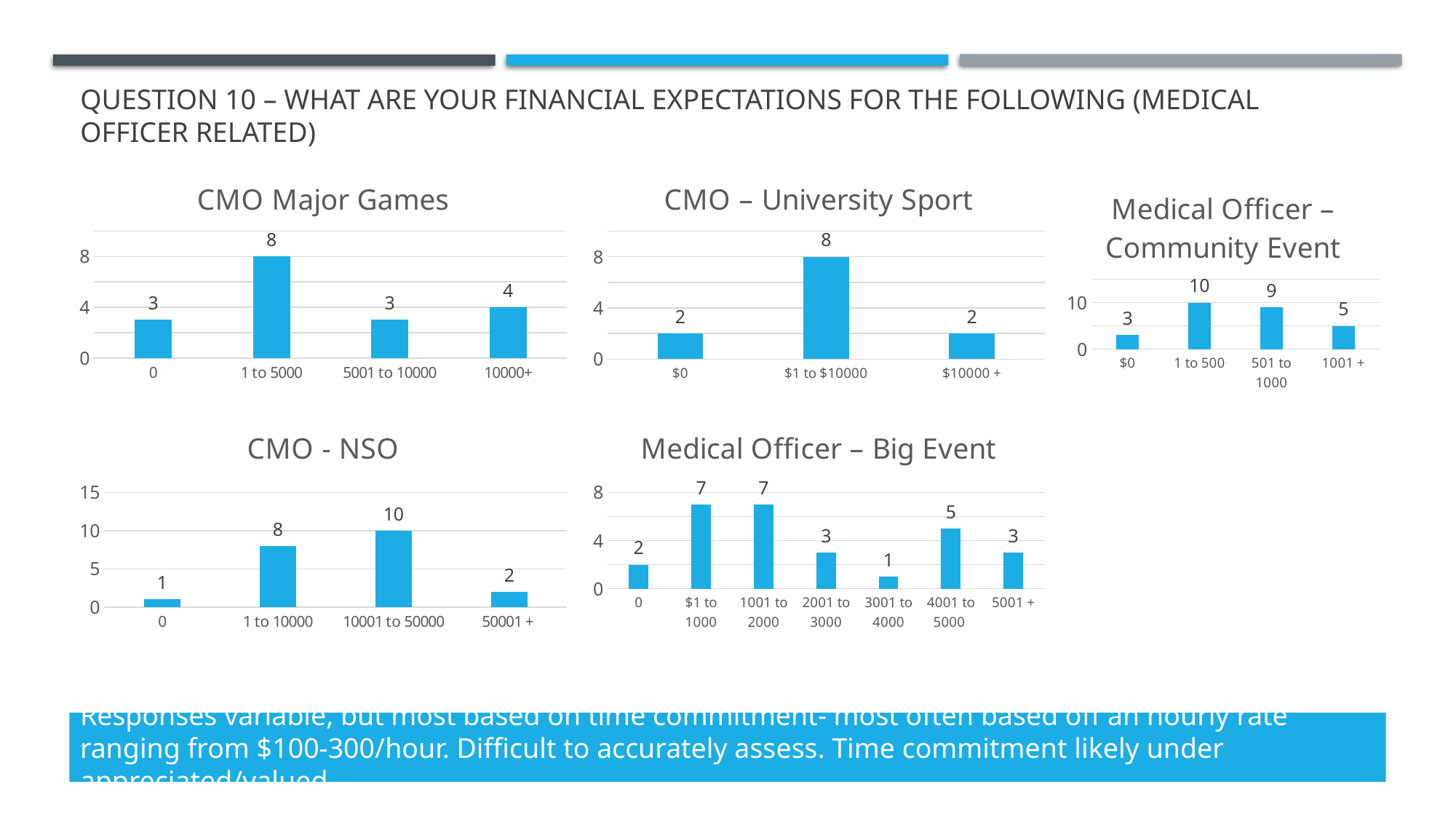
In the CMO Major Games chart, what is the value for the 1 to 5000 category? 8 How many charts are shown on the slide? 5 In the Medical Officer – Community Event chart, what is the value for 1 to 500? 10 In the Medical Officer – Community Event chart, what is the difference between the values for 1 to 500 and 1001 +? 5 In the Medical Officer – Big Event chart, which is larger, the value for 4001 to 5000 or the value for 3001 to 4000? 4001 to 5000 In the CMO - NSO chart, which category has the lowest value? 0 In the CMO – University Sport chart, what is the value for $1 to $10000? 8 In the CMO – University Sport chart, how many categories are shown on the x axis? 3 In the CMO - NSO chart, what is the value for 10001 to 50000? 10 What kind of chart is the CMO - NSO chart? Bar chart In the Medical Officer – Big Event chart, how many categories are shown on the x axis? 7 In the CMO Major Games chart, which category has the highest value? 1 to 5000